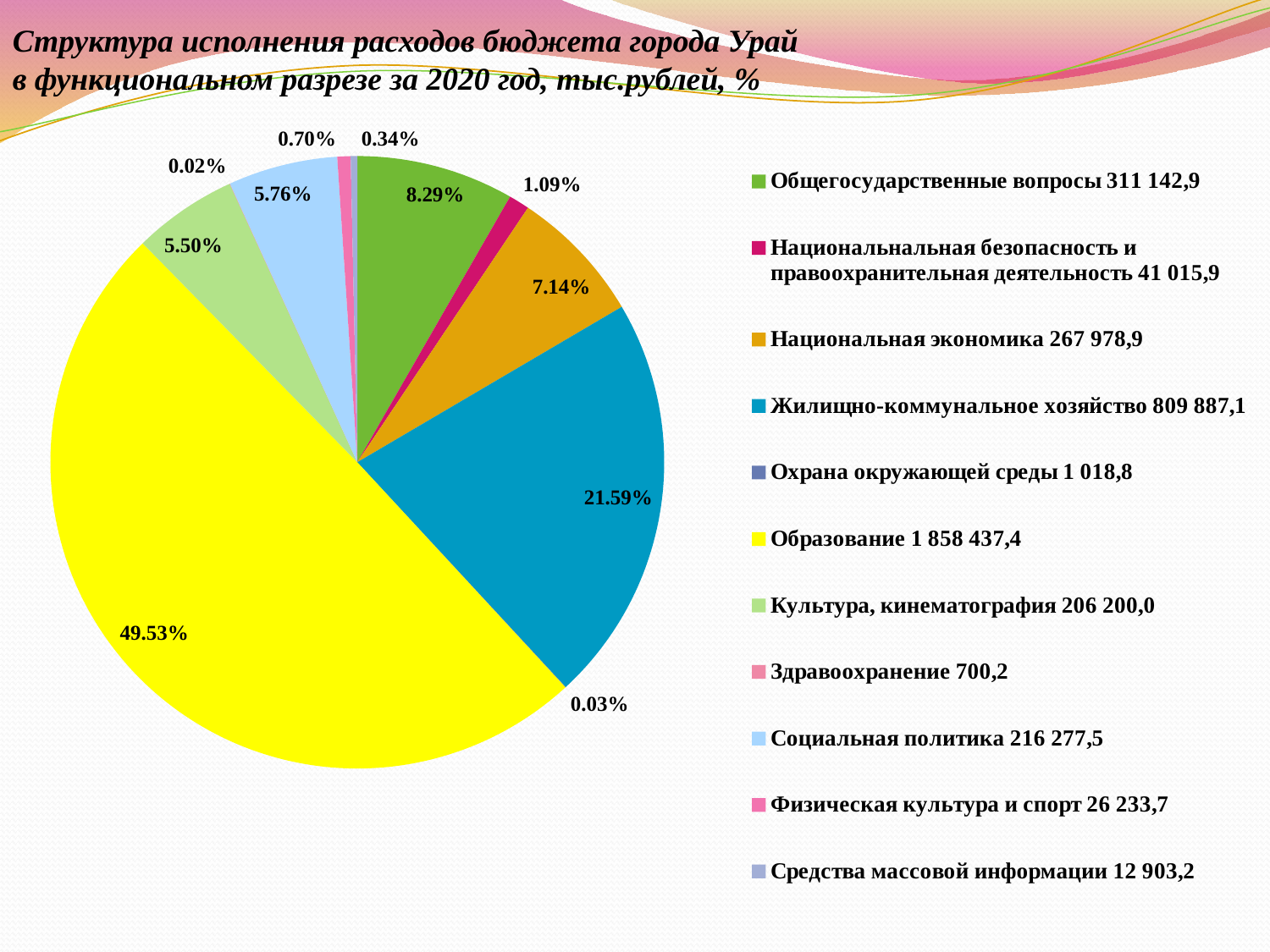
What share of the pie does Национальная экономика take? 7.14% Which slice is larger, Социальная политика or Культура, кинематография? Социальная политика What kind of chart is shown on the slide? pie chart What share of the pie does Жилищно-коммунальное хозяйство take? 21.59% What is the difference in percentage points between the Образование slice and the Жилищно-коммунальное хозяйство slice? 27.94 What value does the legend give for Образование? 1 858 437,4 How many categories does the legend list? 11 What share of the pie does Общегосударственные вопросы take? 8.29% What value does the legend give for Жилищно-коммунальное хозяйство? 809 887,1 Which category has the smallest slice of the pie? Здравоохранение Which category has the largest slice of the pie? Образование